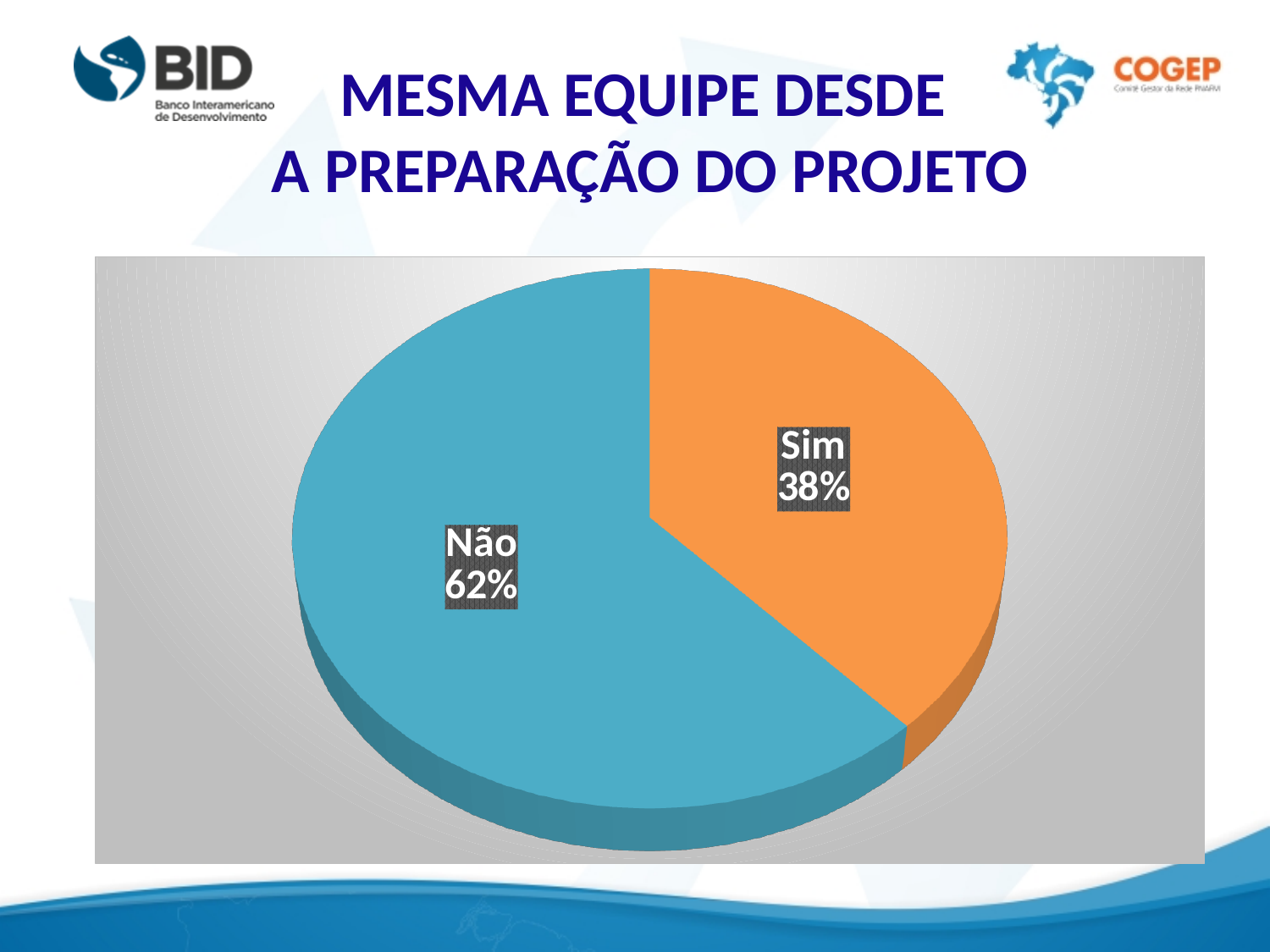
How many slices does the pie chart have? 2 What colour is the "Sim" slice? orange Which slice is the smallest? Sim What kind of chart is shown on the slide? pie chart What share of the pie does the "Sim" slice represent? 38% Which is larger, the "Sim" slice or the "Não" slice? Não What percentage is shown for the "Não" slice? 62% What colour is the "Não" slice? blue Which slice is the largest? Não What percentage is shown for the "Sim" slice? 38% What is the difference in percentage points between the "Não" and "Sim" slices? 24